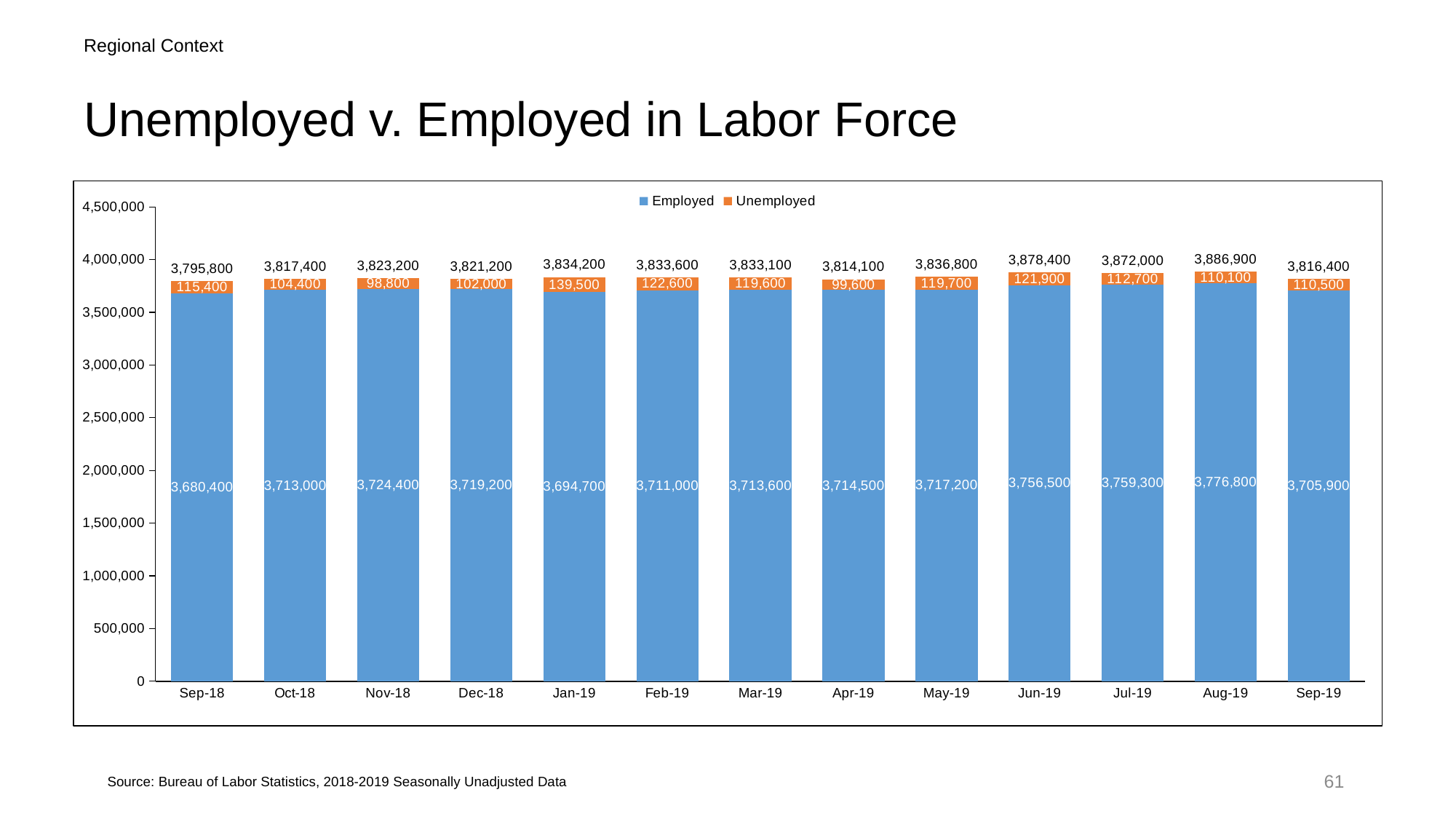
Which month has the lowest Employed value? Sep-18 Is the Employed value for Sep-19 greater or less than the Employed value for Jul-19? less What is the Unemployed value for Jan-19? 139,500 How many months are shown on the x axis? 13 Which month has the lowest Unemployed value? Nov-18 What is the Employed value for Aug-19? 3,776,800 How many series does the legend list? 2 What is the total labor force (Employed plus Unemployed) for Jun-19? 3,878,400 Which series is shown in orange? Unemployed Which month has the highest Unemployed value? Jan-19 What is the difference between the Unemployed values for Jan-19 and Nov-18? 40,700 What type of chart is shown on the slide? Stacked bar chart